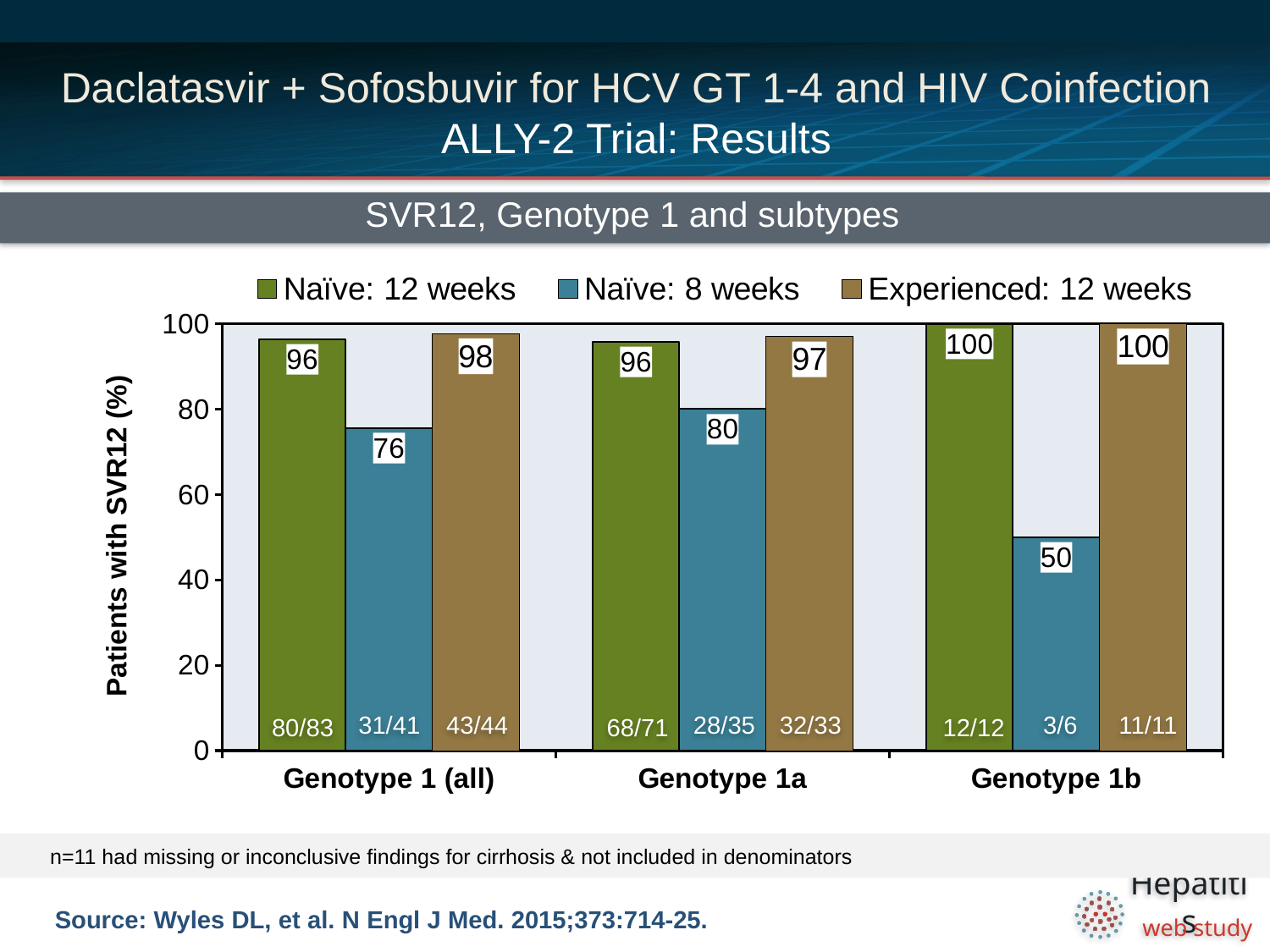
What is the SVR12 value for Naïve: 8 weeks in Genotype 1 (all)? 76 How many series does the legend list? 3 What is the difference between the Naïve: 12 weeks and Naïve: 8 weeks values in Genotype 1 (all)? 20 What is the SVR12 value for Naïve: 12 weeks in Genotype 1a? 96 What kind of chart is shown on the slide? Bar chart How many genotype categories are shown on the x axis? 3 What is the label of the y axis? Patients with SVR12 (%) What is the SVR12 value for Experienced: 12 weeks in Genotype 1a? 97 What is the difference between the Experienced: 12 weeks and Naïve: 8 weeks values in Genotype 1b? 50 What is the SVR12 value for Naïve: 8 weeks in Genotype 1b? 50 Which series has the lowest SVR12 value in Genotype 1b? Naïve: 8 weeks Which is larger, the Naïve: 8 weeks value for Genotype 1a or for Genotype 1b? Genotype 1a